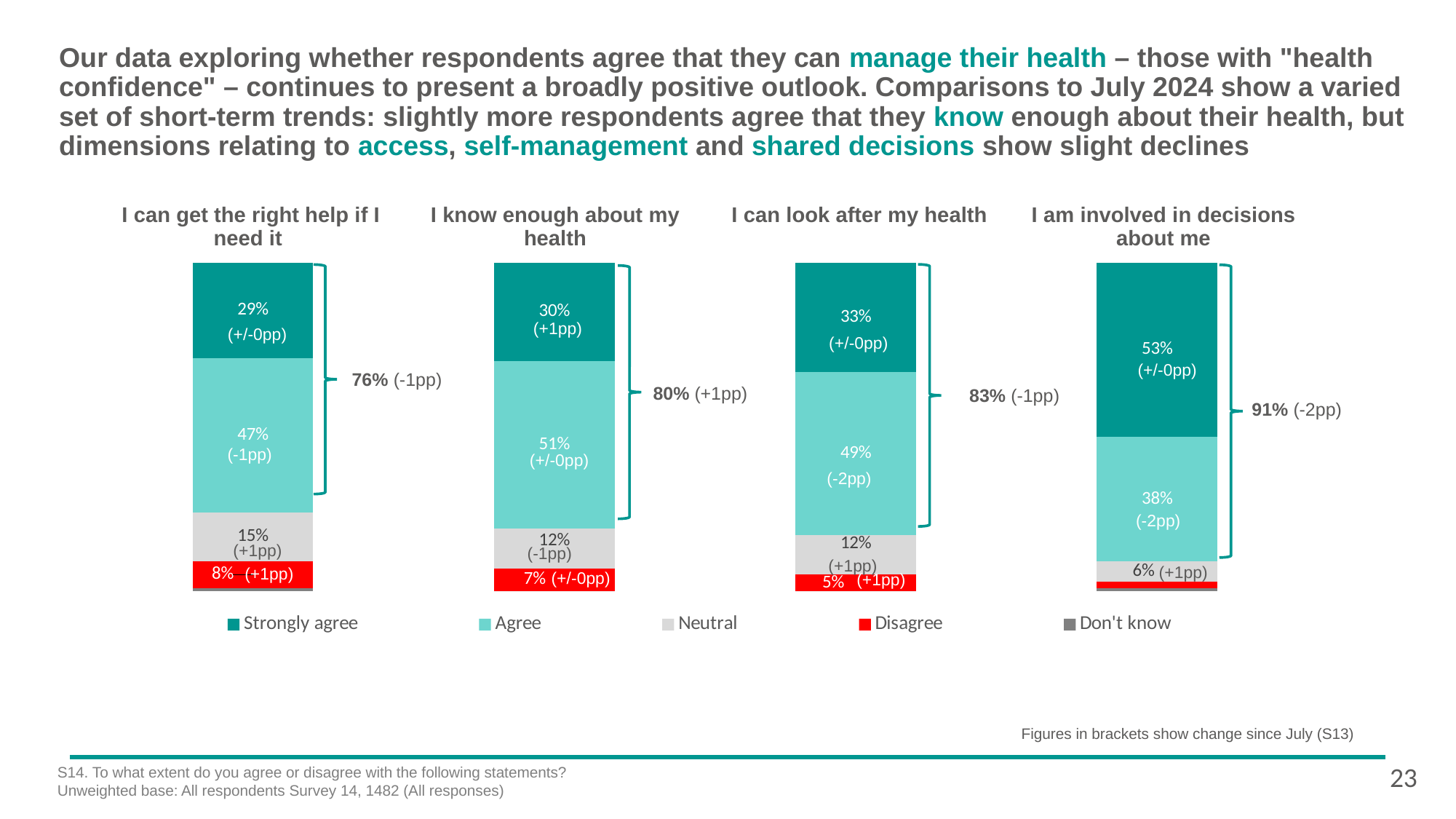
In the chart titled "I know enough about my health", what percentage of respondents agree (not strongly)? 51% In the chart titled "I can get the right help if I need it", what percentage of respondents strongly agree? 29% In the chart titled "I can look after my health", what is the change since July shown for the combined agree figure of 83%? -1pp In the chart titled "I am involved in decisions about me", what percentage of respondents strongly agree? 53% Which is larger: the Neutral share in "I can get the right help if I need it" or the Neutral share in "I know enough about my health"? I can get the right help if I need it How many series does the legend list? 5 Across the four charts, which statement has the lowest combined strongly agree plus agree percentage? I can get the right help if I need it In the chart titled "I can look after my health", what percentage of respondents disagree? 5% In the chart titled "I can get the right help if I need it", what is the difference between the Agree and Strongly agree percentages? 18 percentage points What kind of chart is used to show the responses for each statement? Stacked bar chart Across the four charts, which statement has the highest combined strongly agree plus agree percentage? I am involved in decisions about me In the chart titled "I am involved in decisions about me", what is the combined percentage of respondents who strongly agree or agree? 91%